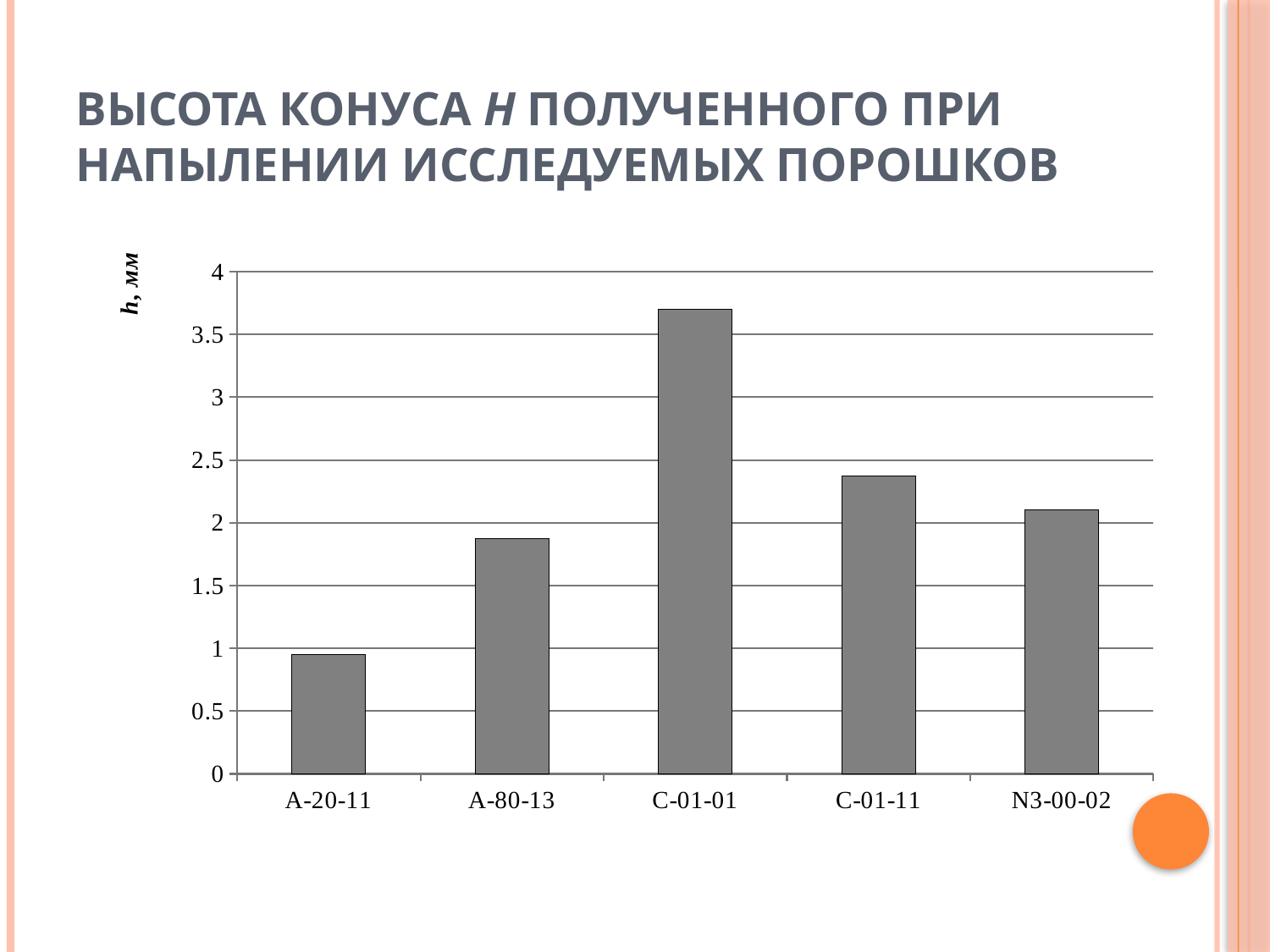
Is the value for A-20-11 greater or less than 1.5? less Which powder has the highest cone height h? C-01-01 Is the value for A-80-13 greater or less than 2? less Is the value for N3-00-02 greater or less than 2.5? less What is the label of the vertical axis? h, мм Which has a larger cone height, C-01-11 or N3-00-02? C-01-11 Which has a larger cone height, A-80-13 or N3-00-02? N3-00-02 What kind of chart is shown on the slide? bar chart Which powder has the lowest cone height h? A-20-11 How many powder categories are shown on the x axis? 5